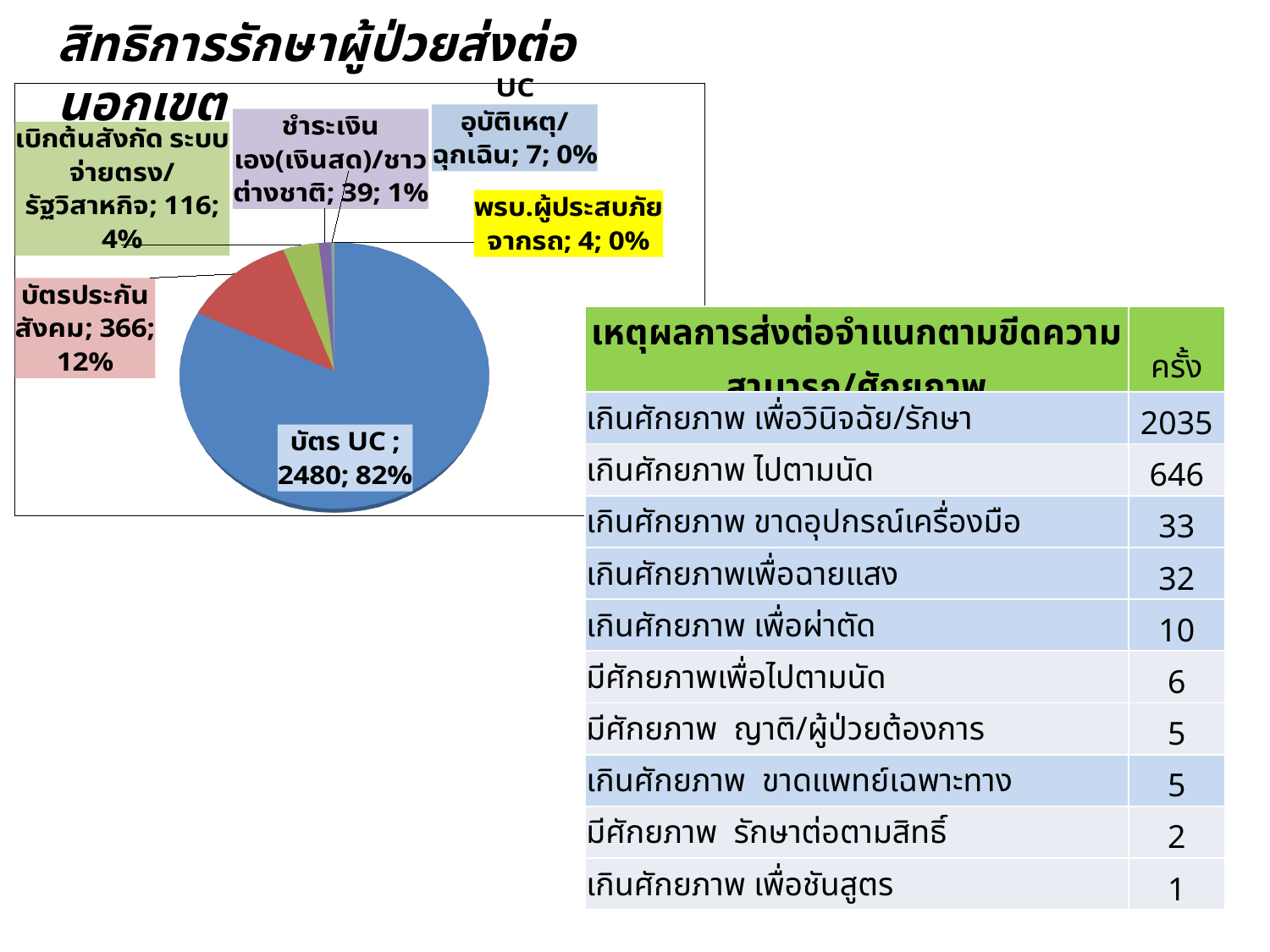
What is the value for เบิกต้นสังกัด ระบบจ่ายตรง/รัฐวิสาหกิจ in the pie chart? 116 How many slices does the pie chart have? 6 Which category has the largest slice in the pie chart? บัตร UC What is the value for บัตร UC in the pie chart? 2480 What share of the pie does บัตรประกันสังคม represent? 12% What is the difference between the values for บัตร UC and บัตรประกันสังคม? 2114 Which category has the smallest slice in the pie chart? พรบ.ผู้ประสบภัยจากรถ What is the value for บัตรประกันสังคม in the pie chart? 366 Which is larger in the pie chart: UC อุบัติเหตุ/ฉุกเฉิน or พรบ.ผู้ประสบภัยจากรถ? UC อุบัติเหตุ/ฉุกเฉิน What is the value for ชำระเงินเอง(เงินสด)/ชาวต่างชาติ in the pie chart? 39 What share of the pie does บัตร UC represent? 82% What kind of chart is shown on the slide? pie chart